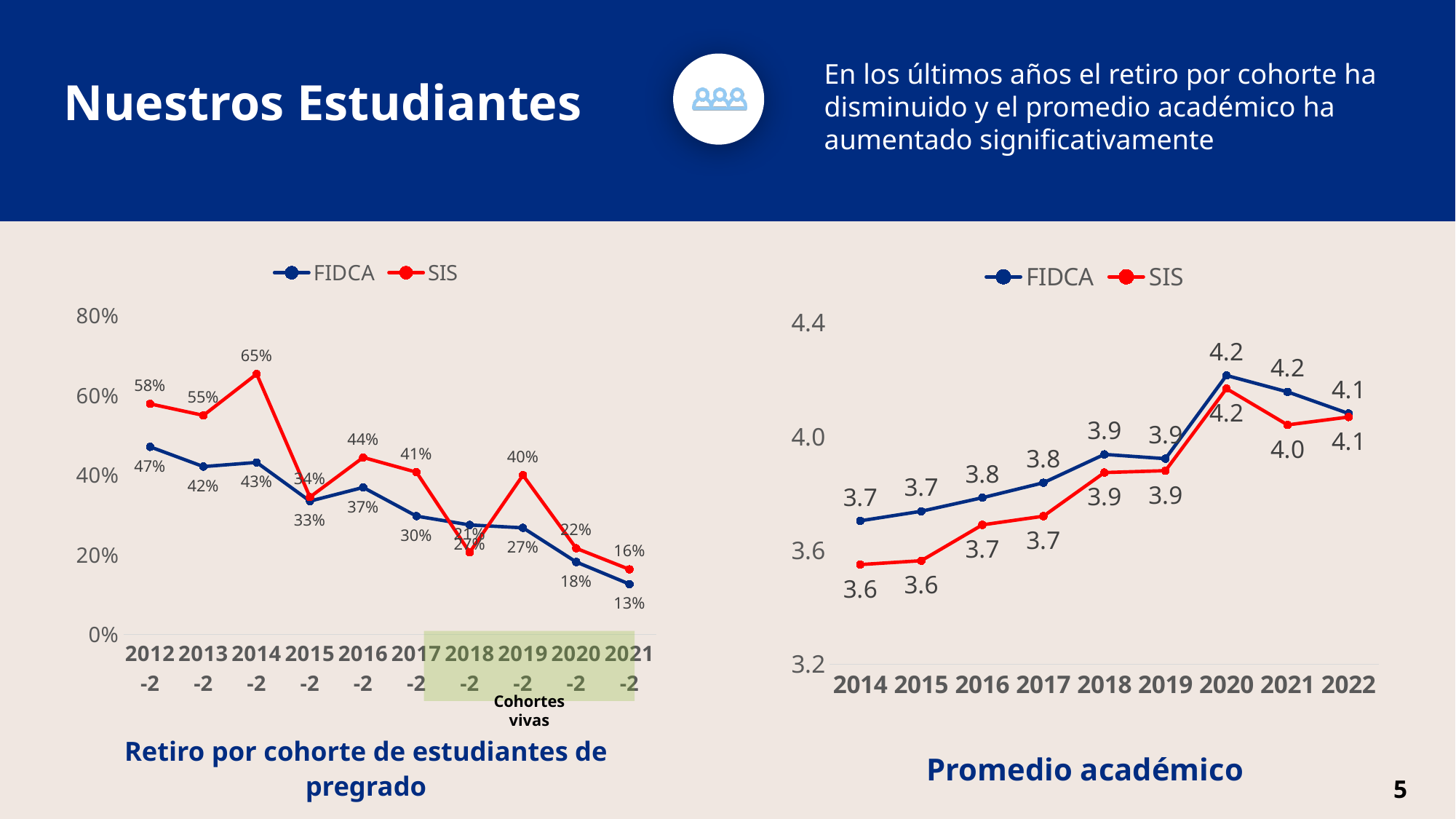
In the 'Retiro por cohorte de estudiantes de pregrado' chart, which year has the highest SIS value? 2014-2 In the 'Retiro por cohorte de estudiantes de pregrado' chart, do the FIDCA values generally rise or fall from 2012-2 to 2021-2? fall In the 'Promedio académico' chart, which series has the larger value in 2016, FIDCA or SIS? FIDCA In the 'Retiro por cohorte de estudiantes de pregrado' chart, what is the FIDCA value for 2021-2? 13% In the 'Retiro por cohorte de estudiantes de pregrado' chart, how many series does the legend list? 2 In the 'Retiro por cohorte de estudiantes de pregrado' chart, what is the difference between the SIS and FIDCA values for 2012-2? 11% In the 'Retiro por cohorte de estudiantes de pregrado' chart, what is the SIS value for 2014-2? 65% In the 'Promedio académico' chart, what is the SIS value for 2021? 4.0 In the 'Retiro por cohorte de estudiantes de pregrado' chart, which series has the larger value in 2019-2, FIDCA or SIS? SIS In the 'Promedio académico' chart, how many years are shown on the x axis? 9 In the 'Promedio académico' chart, what is the FIDCA value for 2014? 3.7 What kind of chart is the 'Promedio académico' chart? line chart